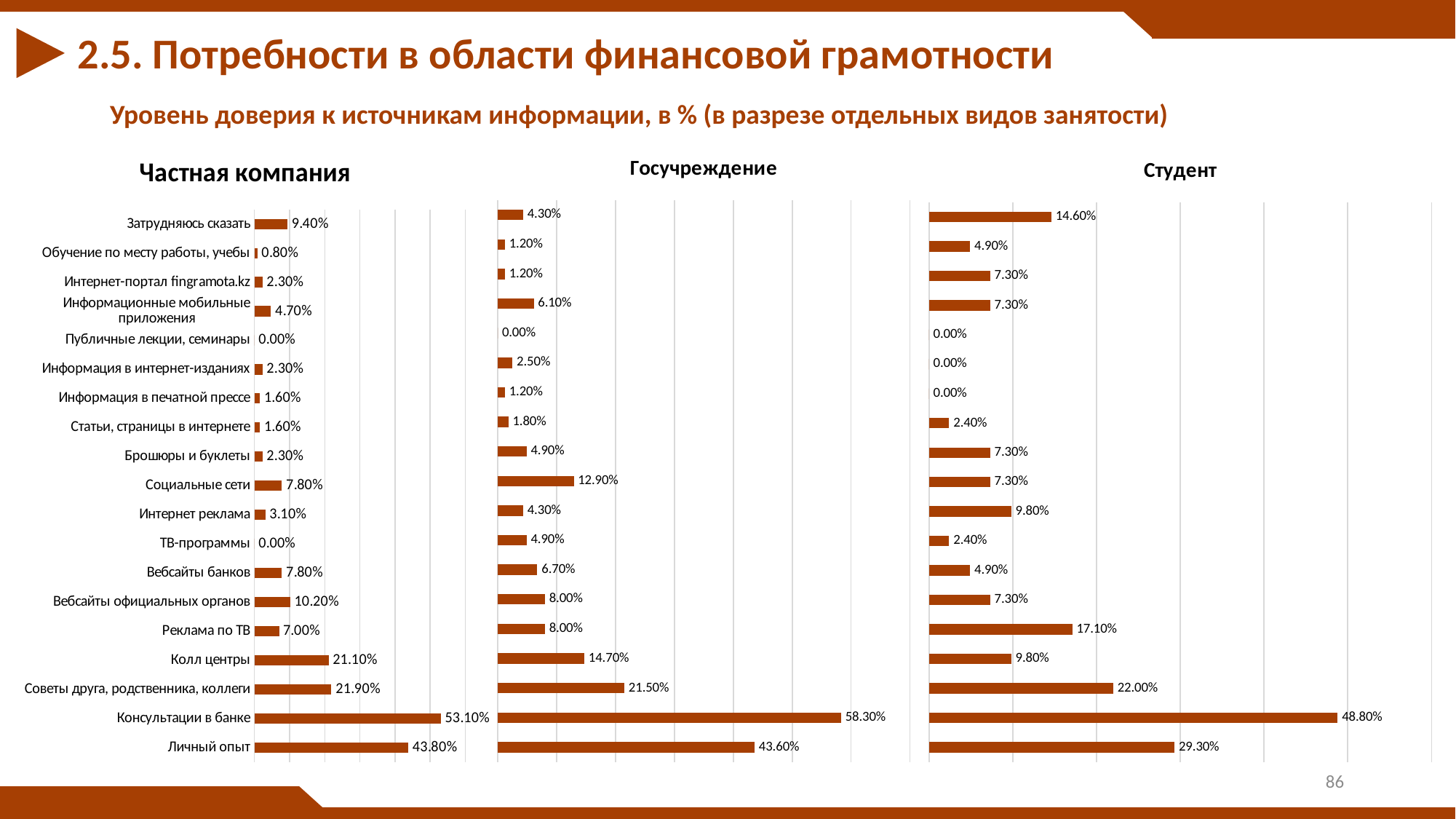
In the 'Госучреждение' chart, which category has the highest value? Консультации в банке In the 'Студент' chart, what is the difference between 'Консультации в банке' and 'Личный опыт'? 19.50% What kind of chart is the 'Госучреждение' chart? Bar chart How many categories are shown in the 'Частная компания' chart? 19 In the 'Госучреждение' chart, what is the value for 'Социальные сети'? 12.90% In the 'Студент' chart, which category has the highest value? Консультации в банке In the 'Студент' chart, what is the value for 'Реклама по ТВ'? 17.10% How many charts are shown on the slide? 3 In the 'Студент' chart, which is larger: 'Затрудняюсь сказать' or 'Интернет реклама'? Затрудняюсь сказать In the 'Частная компания' chart, what is the value for 'Консультации в банке'? 53.10% In the 'Госучреждение' chart, which is larger: 'Колл центры' or 'Советы друга, родственника, коллеги'? Советы друга, родственника, коллеги In the 'Частная компания' chart, what is the difference between 'Консультации в банке' and 'Личный опыт'? 9.30%